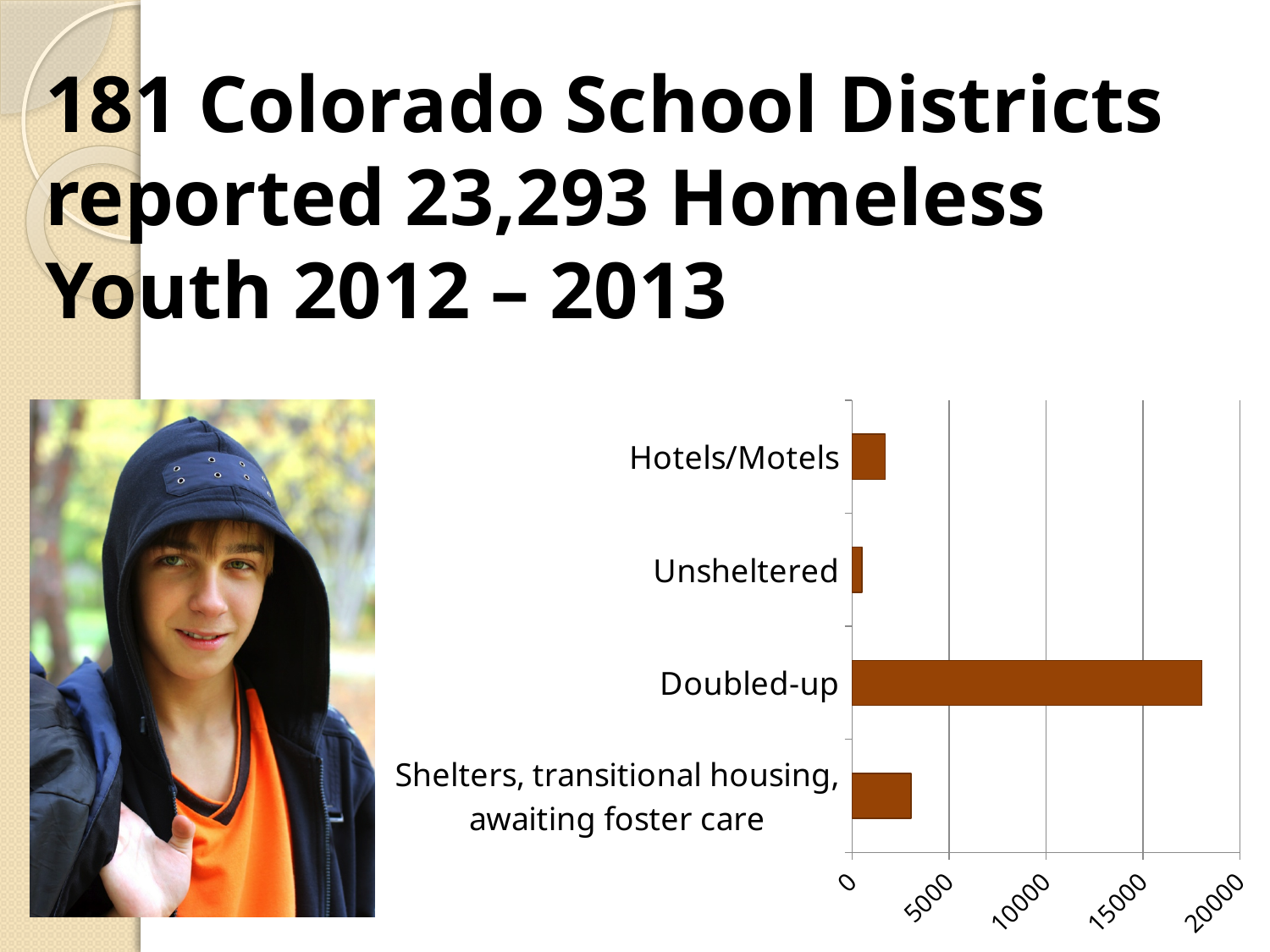
Is the value for Doubled-up greater or less than 20000? less Is the value for Hotels/Motels greater or less than 5000? less Which category has the lowest value in the chart? Unsheltered What is the highest tick value shown on the chart's value axis? 20000 Which is larger, the value for Shelters, transitional housing, awaiting foster care or the value for Hotels/Motels? Shelters, transitional housing, awaiting foster care How many categories are plotted in the chart? 4 Which is larger, the value for Doubled-up or the value for Hotels/Motels? Doubled-up Which is larger, the value for Hotels/Motels or the value for Unsheltered? Hotels/Motels What kind of chart is shown on the slide? Bar chart Which category has the highest value in the chart? Doubled-up Is the value for Shelters, transitional housing, awaiting foster care greater or less than 5000? less